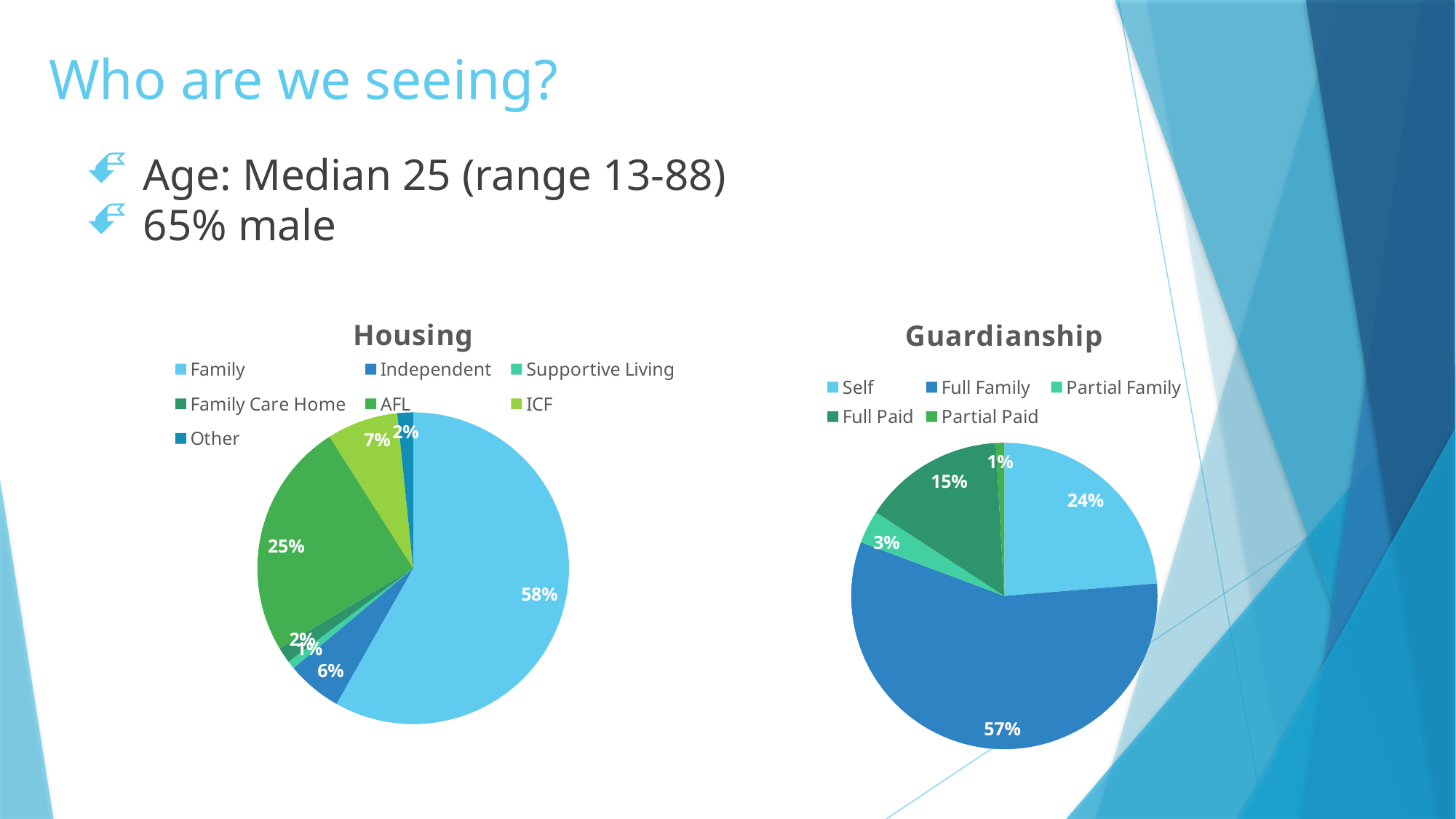
In the Guardianship chart, which is larger, Full Paid or Partial Family? Full Paid In the Housing chart, what percentage is shown for ICF? 7% In the Housing chart, what percentage is shown for AFL? 25% In the Housing chart, how many categories does the legend list? 7 In the Guardianship chart, which category has the smallest slice? Partial Paid In the Housing chart, what share of the pie is Family? 58% In the Guardianship chart, what percentage is shown for Self? 24% In the Housing chart, what is the difference between the Family and AFL shares? 33% In the Guardianship chart, what share of the pie is Full Family? 57% In the Housing chart, what percentage is shown for Independent? 6% What type of chart is the Guardianship chart? Pie chart In the Housing chart, which category has the largest slice? Family